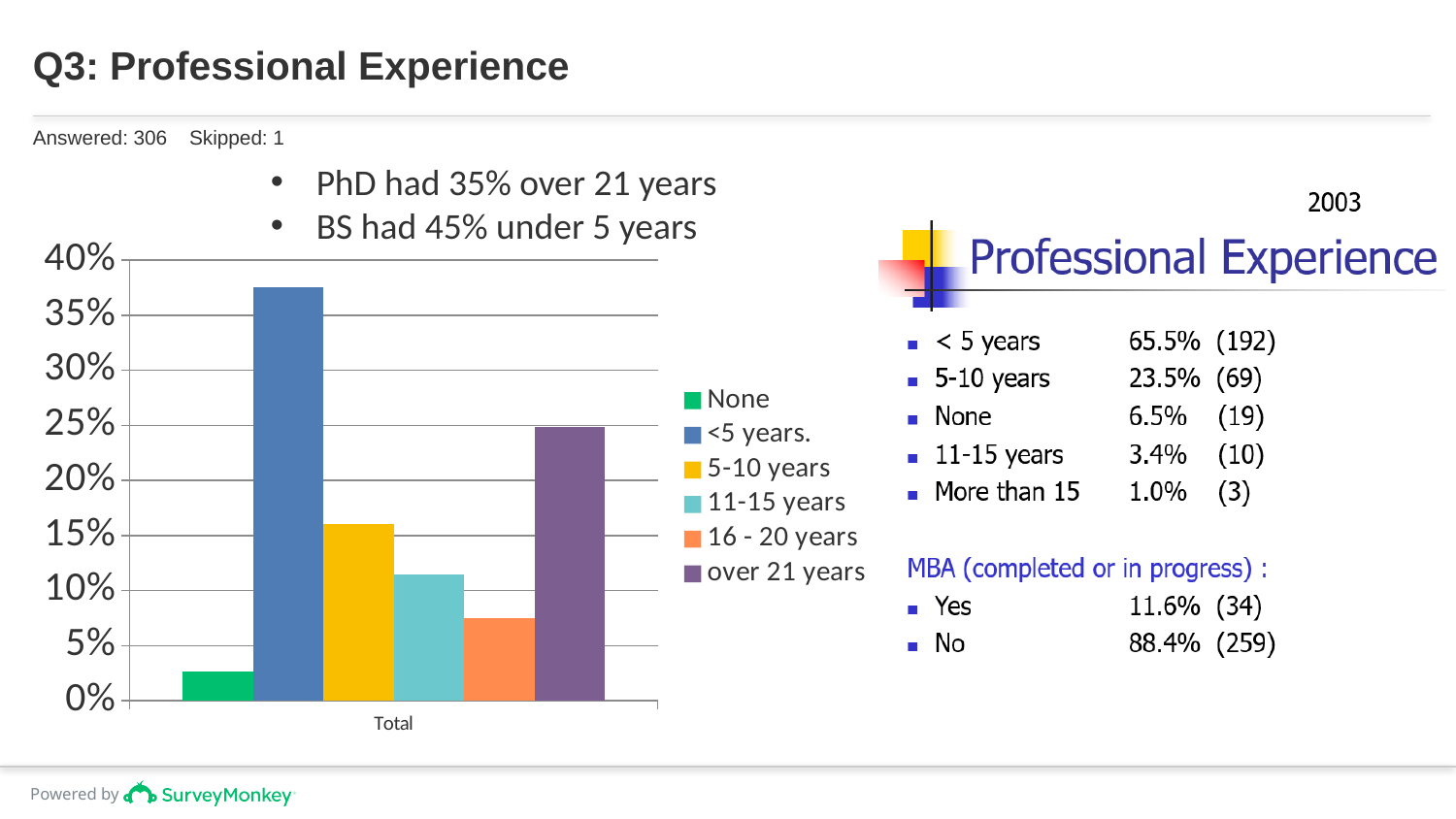
What is the category label shown on the x axis of the chart? Total Is the value for over 21 years greater or less than 20%? greater Is the value for 16 - 20 years greater or less than 10%? less How many series does the chart legend list? 6 Which is larger, the bar for over 21 years or the bar for 5-10 years? over 21 years Which is larger, the bar for 11-15 years or the bar for 16 - 20 years? 11-15 years Which series has the shortest bar in the chart? None What kind of chart is shown on the slide? bar chart Which series has the tallest bar in the chart? <5 years. Is the value for None greater or less than 5%? less